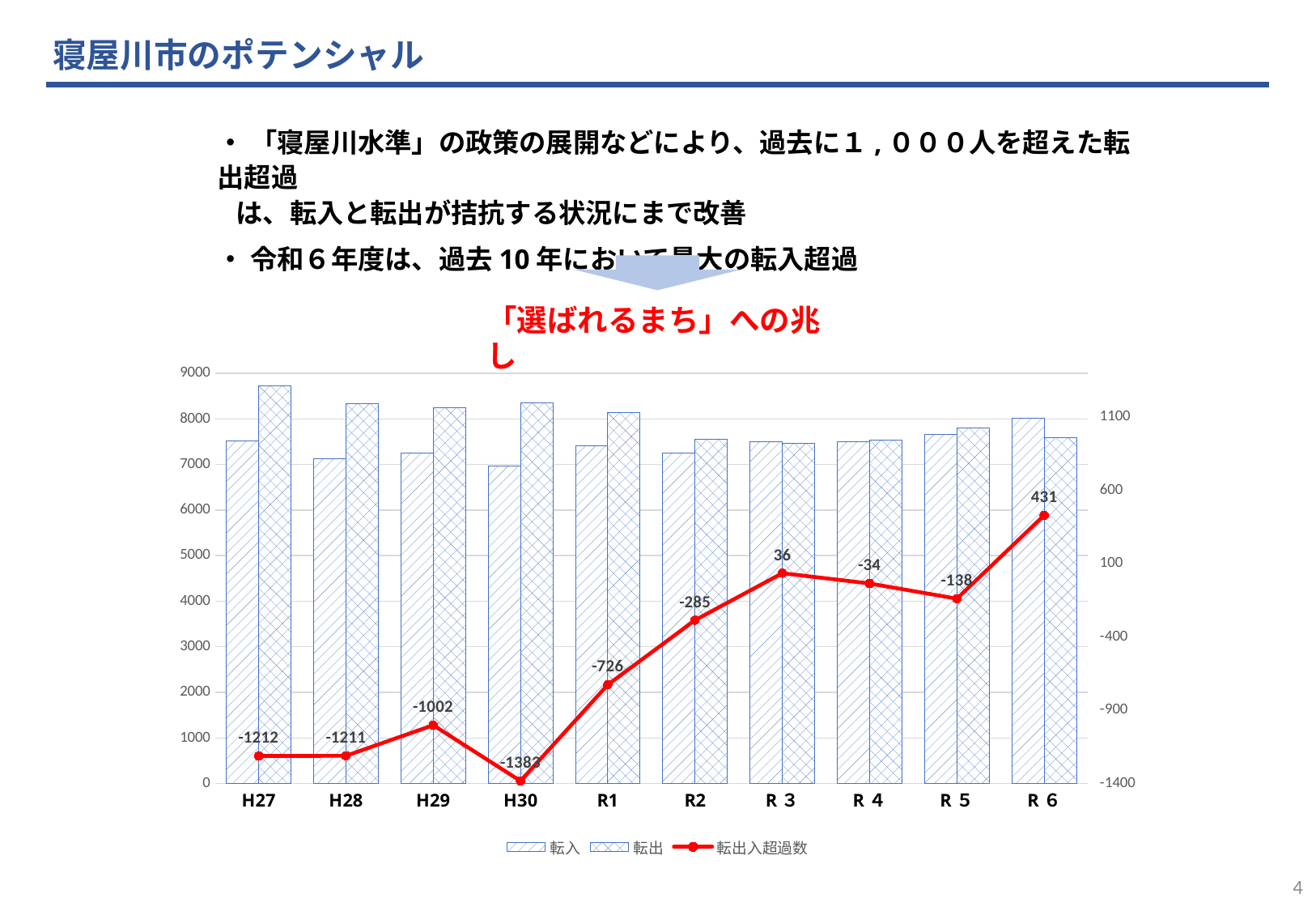
What is the value of 転出入超過数 for R 3? 36 What is the value of 転出入超過数 for H30? -1383 Which year has the lowest 転出入超過数 value? H30 Is the 転出 bar for H27 greater or less than 8000? greater What kind of chart is shown on the slide? Combination bar and line chart How many years are shown on the x axis? 10 Which year has the highest 転出入超過数 value? R 6 What is the difference between the 転出入超過数 values for R 6 and R 3? 395 How many series does the legend list? 3 Which is larger, the 転出入超過数 value for R 2 or for R 5? R 5 What is the value of 転出入超過数 for R 6? 431 Does the 転出入超過数 line rise or fall from R1 to R 3? rise